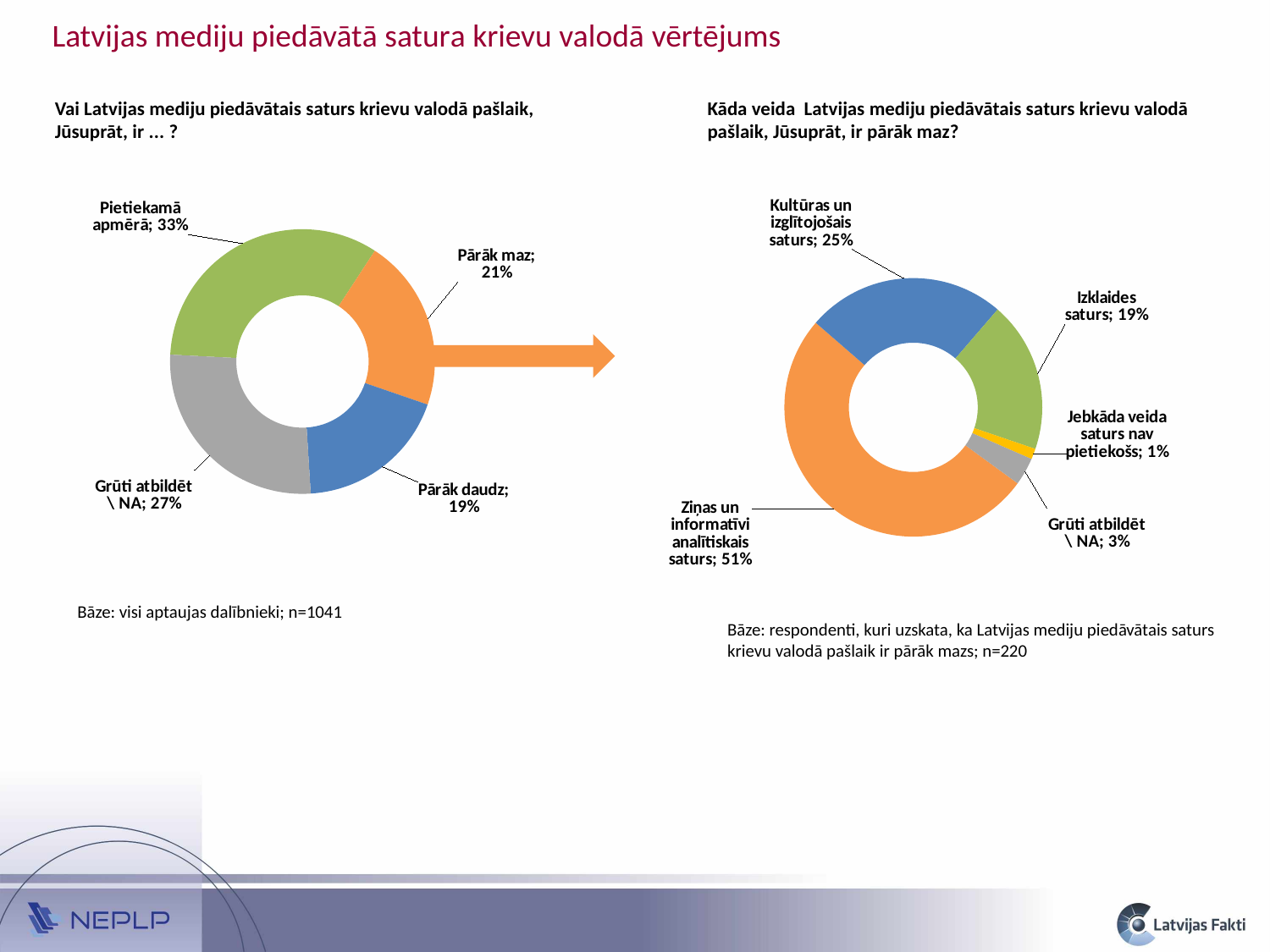
In the right chart, which is larger: "Kultūras un izglītojošais saturs" or "Izklaides saturs"? Kultūras un izglītojošais saturs In the left chart, which category has the smallest share? Pārāk daudz How many categories does the right chart show? 5 In the left chart, what is the value for "Pārāk daudz"? 19% How many categories does the left chart show? 4 In the right chart, what is the value for "Ziņas un informatīvi analītiskais saturs"? 51% In the left chart, which category has the largest share? Pietiekamā apmērā In the right chart, which category has the smallest share? Jebkāda veida saturs nav pietiekošs In the left chart, what share of respondents answered "Pietiekamā apmērā"? 33% What type of chart is used on the right side of the slide? Doughnut (pie) chart In the left chart, what is the difference between "Grūti atbildēt \ NA" and "Pārāk maz"? 6 percentage points In the right chart, what share is given for "Jebkāda veida saturs nav pietiekošs"? 1%